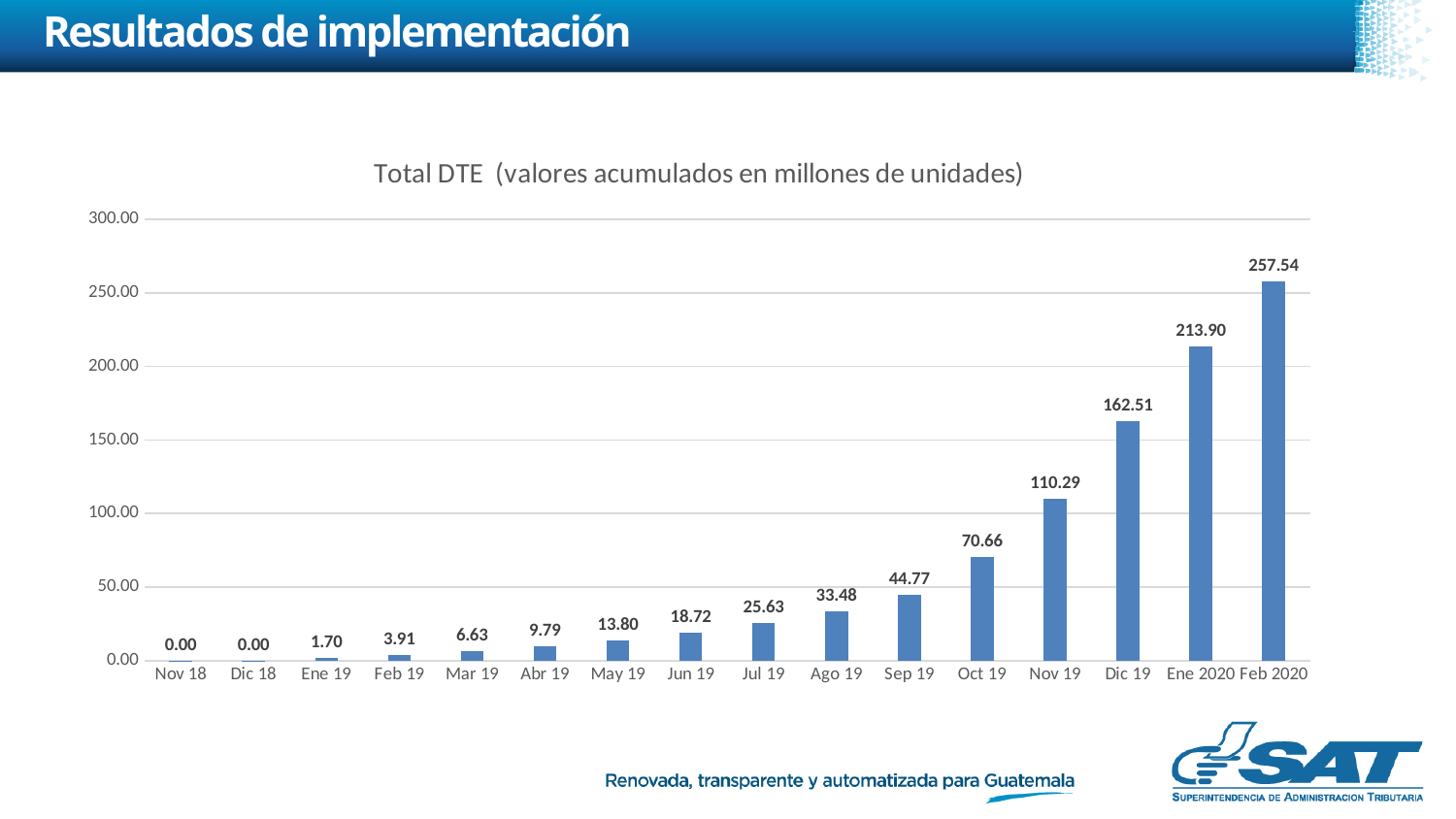
Do the values rise or fall from Nov 18 to Feb 2020? rise What kind of chart is shown? bar chart What is the value for Jun 19? 18.72 Which month has the highest value? Feb 2020 What is the difference between the values for Feb 2020 and Ene 2020? 43.64 How many months are shown on the x axis? 16 What is the difference between the values for Dic 19 and Nov 19? 52.22 What is the value for Feb 2020? 257.54 Is the value for Dic 19 greater or less than 150.00? greater What is the title of the chart? Total DTE (valores acumulados en millones de unidades) What is the value for Oct 19? 70.66 Which is larger, the value for Sep 19 or the value for Ago 19? Sep 19